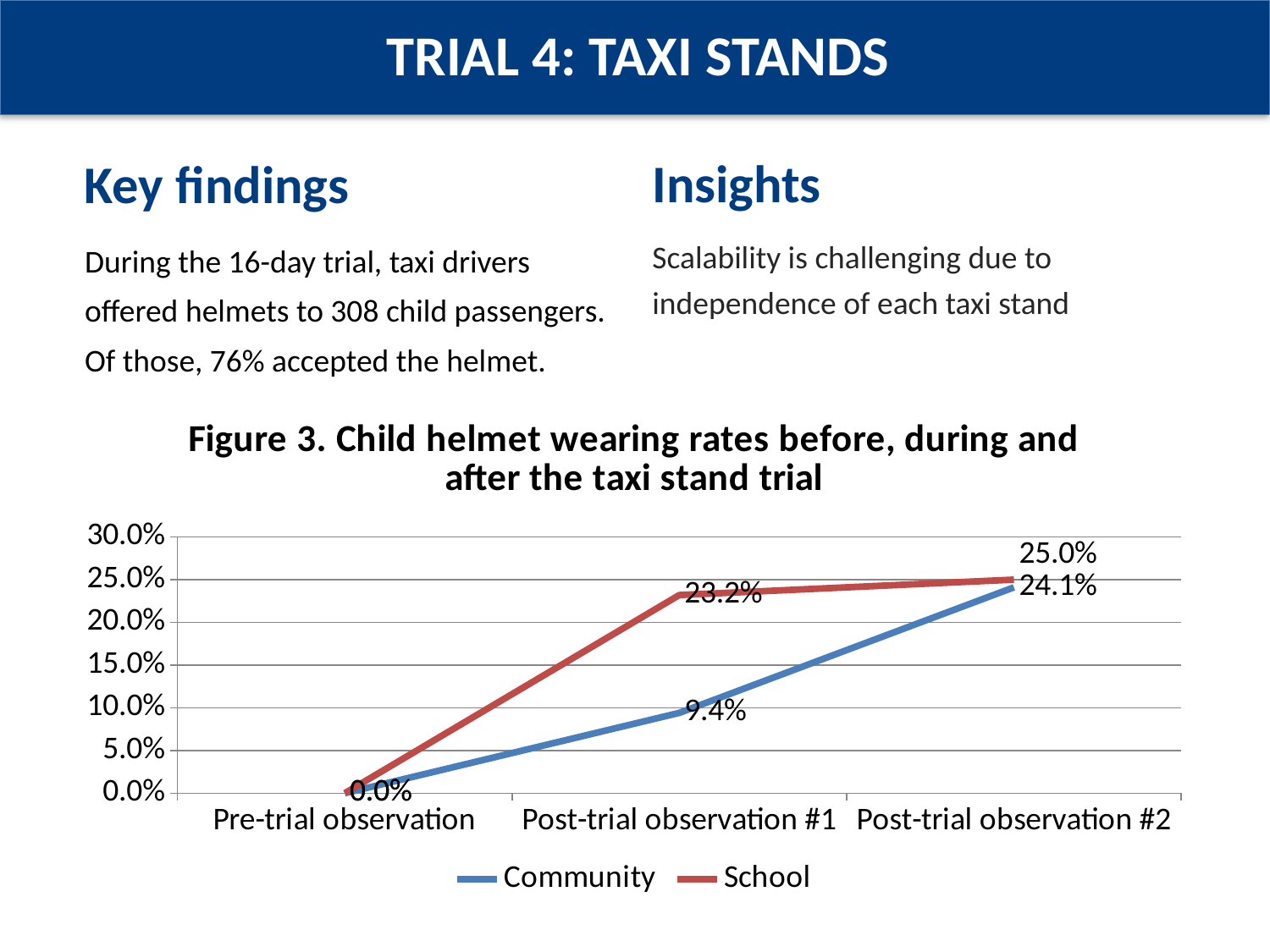
Which colour represents the School series in Figure 3? red What is the difference between the School and Community rates at Post-trial observation #1? 13.8% What type of chart is shown in Figure 3? line chart What is the School helmet wearing rate at Post-trial observation #2? 25.0% What is the School helmet wearing rate at Post-trial observation #1? 23.2% What is the Community helmet wearing rate at Post-trial observation #2? 24.1% At Post-trial observation #1, which series has the higher helmet wearing rate, Community or School? School How many observation points are plotted along the x axis of Figure 3? 3 What value is labelled at the Pre-trial observation point? 0.0% How many series does the legend of Figure 3 list? 2 What is the Community helmet wearing rate at Post-trial observation #1? 9.4% Does the Community helmet wearing rate rise or fall from Pre-trial observation to Post-trial observation #2? rise